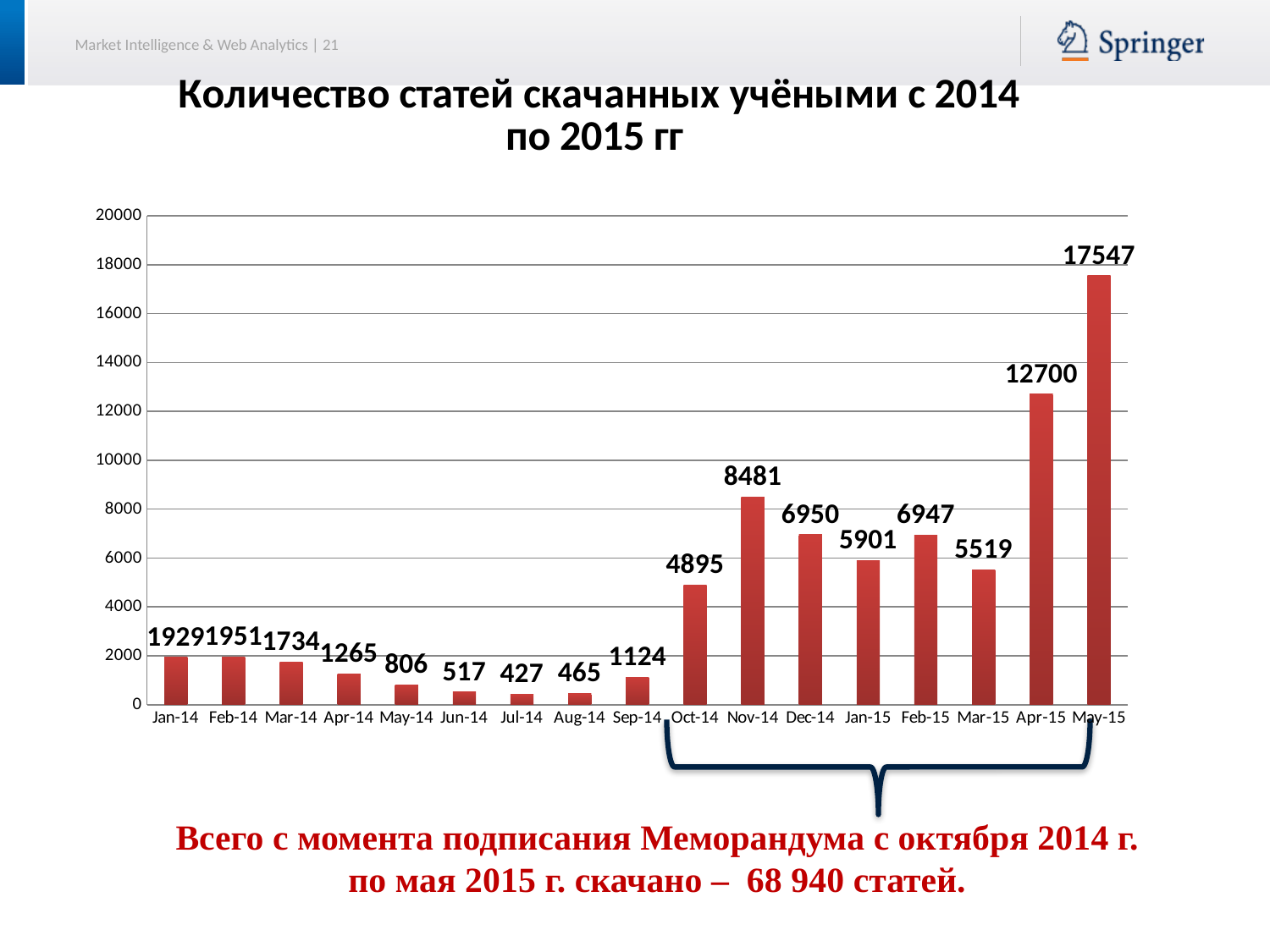
What is the difference between the values for May-15 and Apr-15? 4847 What is the value for Sep-14? 1124 Which is larger, the value for Nov-14 or the value for Jan-15? Nov-14 What is the value for May-15? 17547 What is the difference between the values for Nov-14 and Oct-14? 3586 Do the values rise or fall from Nov-14 to Jan-15? fall Which month has the lowest value? Jul-14 Is the value for Mar-15 greater or less than 6000? less Which month has the highest value? May-15 What is the value for Oct-14? 4895 How many months are shown on the x axis? 17 What kind of chart is shown on the slide? bar chart